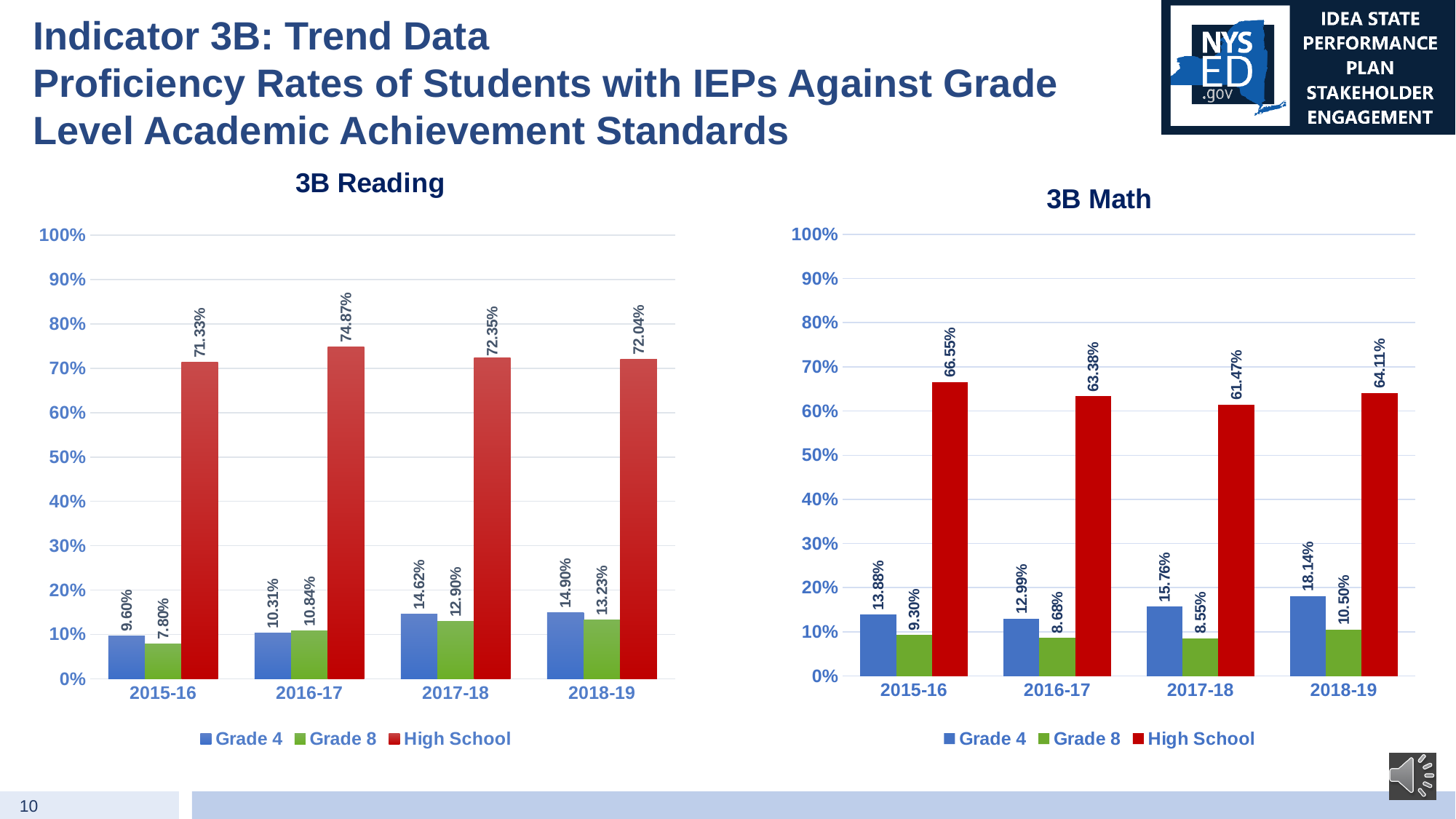
How many series does the legend of the 3B Math chart list? 3 How many years are shown on the x axis of the 3B Reading chart? 4 In the 3B Reading chart, which year has the lowest Grade 4 proficiency rate? 2015-16 In the 3B Math chart, what is the Grade 4 proficiency rate for 2018-19? 18.14% In the 3B Math chart, is the High School value for 2017-18 greater or less than 70%? less In the 3B Reading chart, does the Grade 8 proficiency rate rise or fall from 2015-16 to 2018-19? Rise In the 3B Reading chart, which is larger: the Grade 4 value for 2018-19 or the Grade 8 value for 2018-19? Grade 4 (14.90%) In the 3B Reading chart, what is the Grade 8 value for 2015-16? 7.80% In the 3B Math chart, what is the difference between the Grade 4 and Grade 8 values for 2017-18? 7.21% In the 3B Reading chart, what is the High School proficiency rate for 2016-17? 74.87% In the 3B Math chart, which year has the highest High School proficiency rate? 2015-16 What kind of chart is the 3B Reading chart? Bar chart